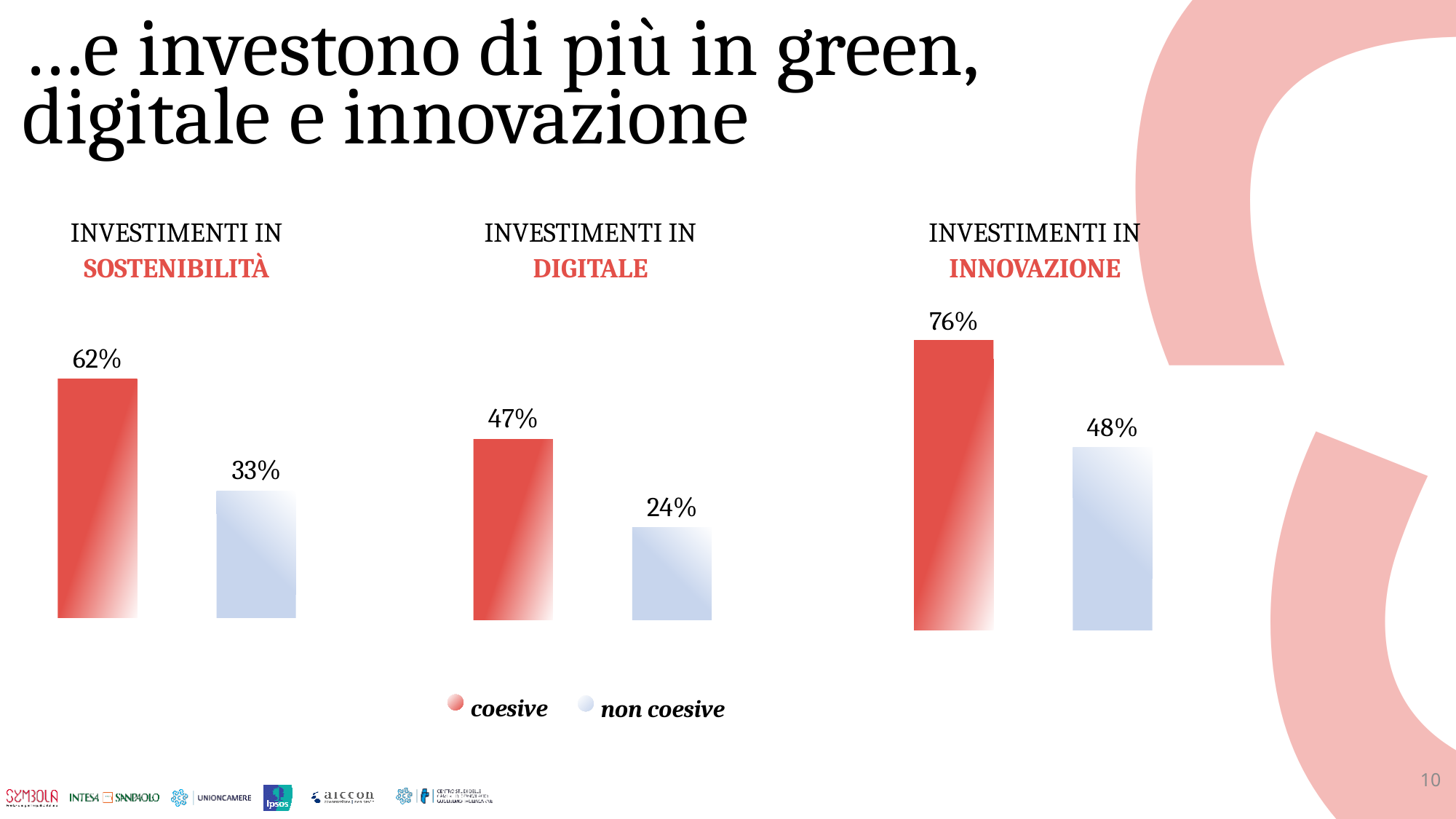
Across the three charts, which chart has the highest coesive value? INVESTIMENTI IN INNOVAZIONE In the 'INVESTIMENTI IN SOSTENIBILITÀ' chart, what is the value for non coesive? 33% In the 'INVESTIMENTI IN DIGITALE' chart, what is the value for coesive? 47% In the 'INVESTIMENTI IN INNOVAZIONE' chart, what is the value for non coesive? 48% What kind of chart is used on this slide? bar chart In the 'INVESTIMENTI IN DIGITALE' chart, what is the value for non coesive? 24% How many series does the legend list? 2 In the 'INVESTIMENTI IN SOSTENIBILITÀ' chart, what is the value for coesive? 62% In the 'INVESTIMENTI IN SOSTENIBILITÀ' chart, what is the difference between the coesive and non coesive values? 29% In the 'INVESTIMENTI IN DIGITALE' chart, what is the difference between the coesive and non coesive values? 23% In the 'INVESTIMENTI IN INNOVAZIONE' chart, what is the value for coesive? 76% In the 'INVESTIMENTI IN INNOVAZIONE' chart, which is larger, coesive or non coesive? coesive